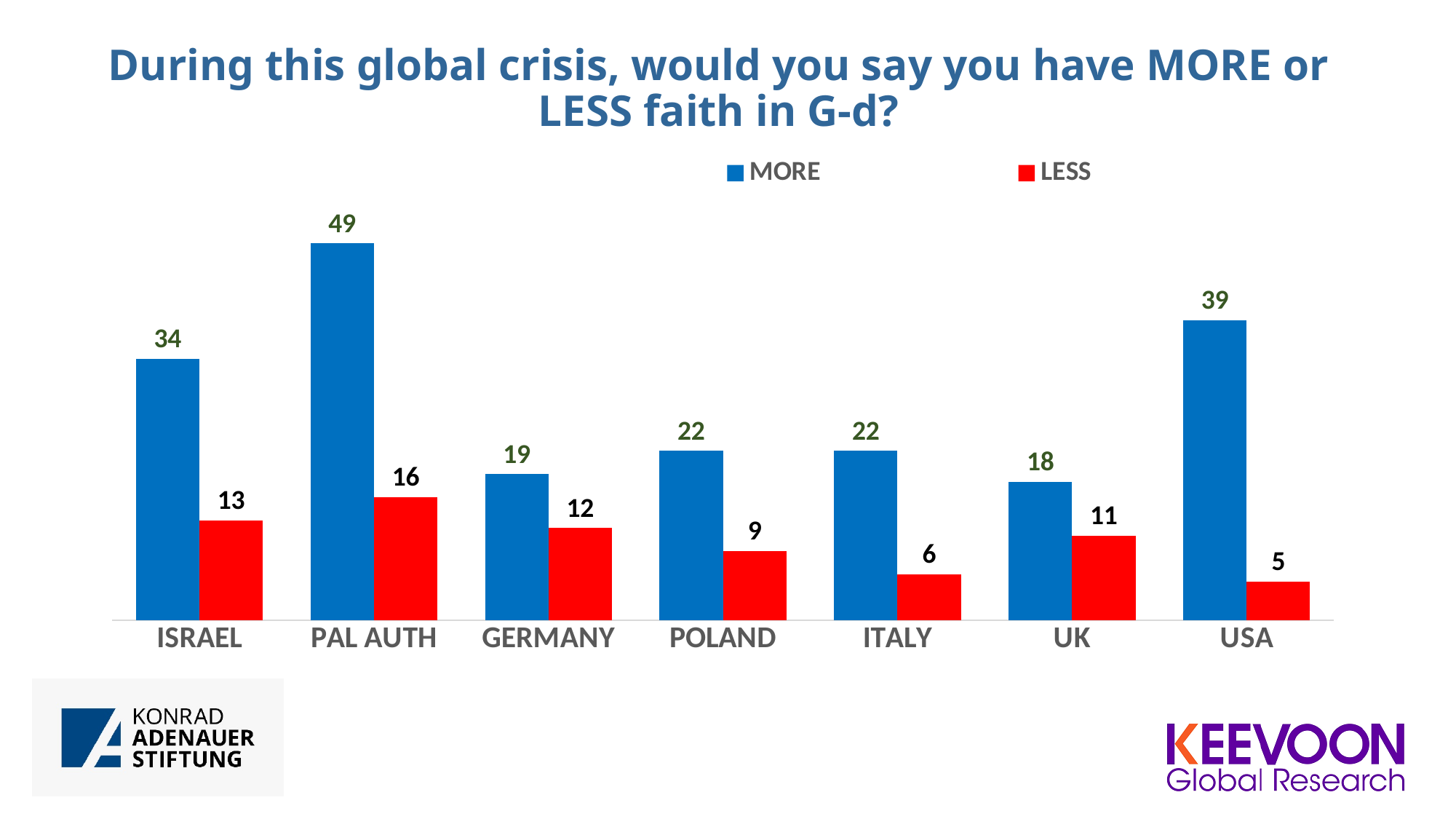
What is the MORE value for PAL AUTH? 49 How many countries are shown on the x axis? 7 What colour are the LESS bars? red What is the difference between the LESS values for PAL AUTH and ITALY? 10 What kind of chart is shown on the slide? bar chart What is the difference between the MORE and LESS values for USA? 34 How many series does the legend list? 2 Which is larger, the MORE value for ISRAEL or the MORE value for USA? USA Which country has the lowest LESS value? USA Which country has the highest MORE value? PAL AUTH What is the MORE value for UK? 18 What is the LESS value for USA? 5